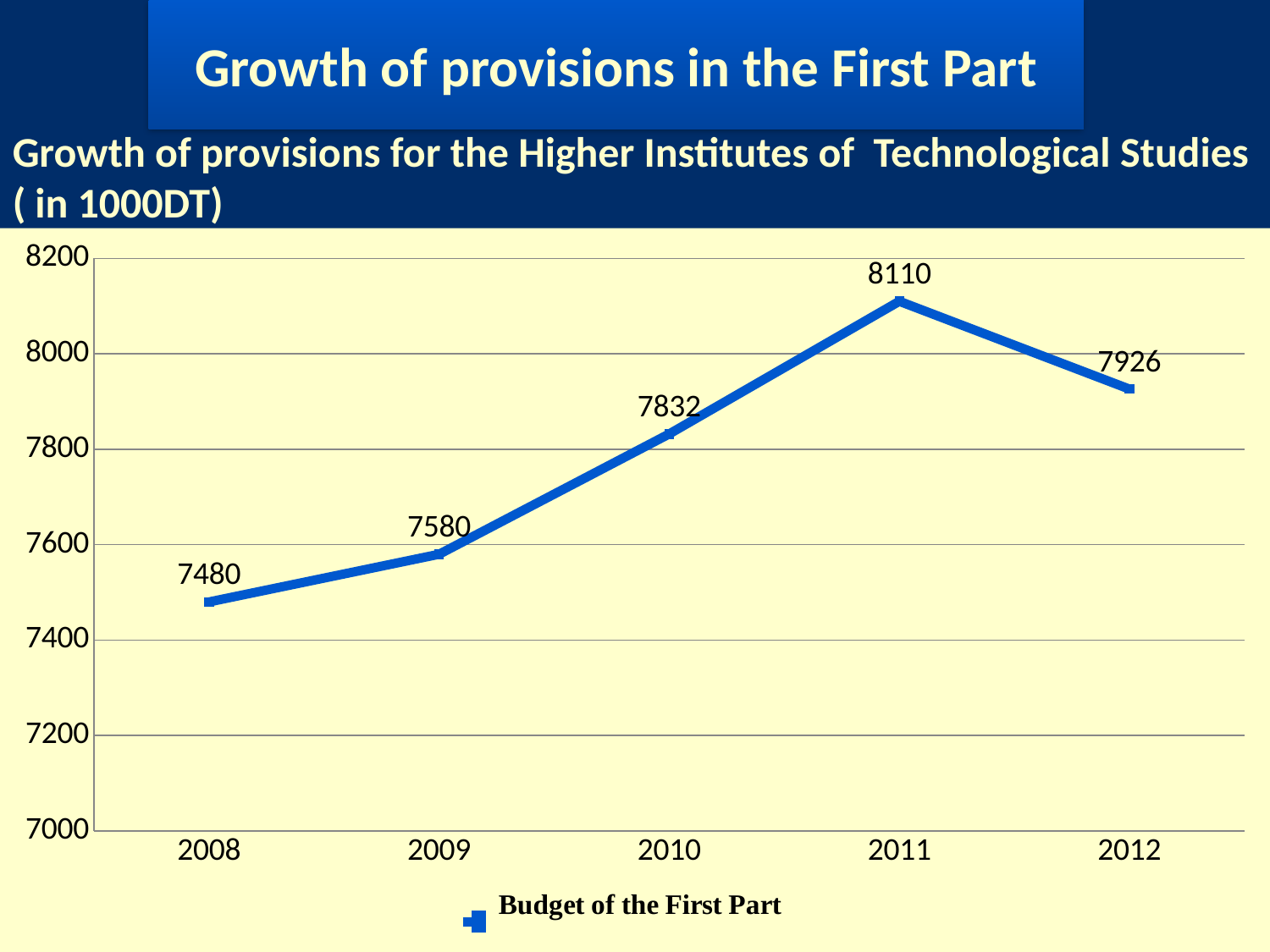
Which year has the highest value? 2011 Is the value for 2010 greater or less than 7800? greater What is the difference between the values for 2009 and 2008? 100 How many years are plotted on the x axis? 5 What series name does the legend show? Budget of the First Part What is the value for 2012? 7926 What is the difference between the values for 2011 and 2010? 278 Which is larger, the value for 2010 or the value for 2012? 2012 What kind of chart is shown? line chart What is the value for 2011? 8110 What is the value for 2008? 7480 Which year has the lowest value? 2008